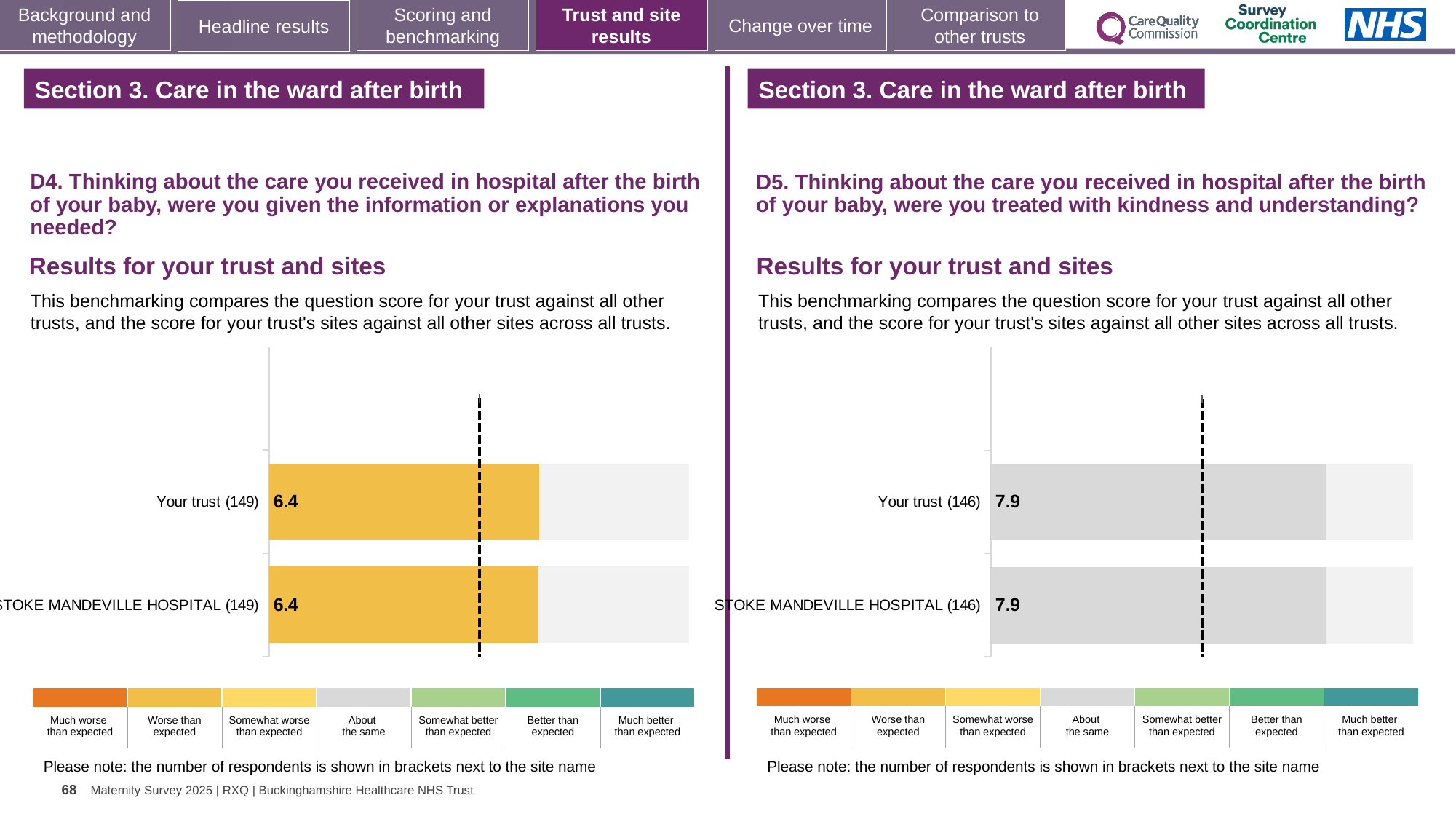
What kind of chart is used on the left (D4)? Bar chart On the right chart (D5), how many respondents are shown in brackets for Stoke Mandeville Hospital? 146 On the right chart (D5), what is the difference between the score for Your trust and the score for Stoke Mandeville Hospital? 0 On the left chart (D4), what is the score for Stoke Mandeville Hospital? 6.4 On the right chart (D5), what is the score for Your trust? 7.9 Is the score for Your trust on the right chart (D5) larger than the score for Your trust on the left chart (D4)? Yes On the left chart (D4), what is the difference between the score for Your trust and the score for Stoke Mandeville Hospital? 0 On the left chart (D4), what is the score for Your trust? 6.4 On the right chart (D5), what is the score for Stoke Mandeville Hospital? 7.9 On the left chart (D4), how many respondents are shown in brackets for Your trust? 149 How many bars are plotted on the left chart (D4)? 2 How many bars are plotted on the right chart (D5)? 2